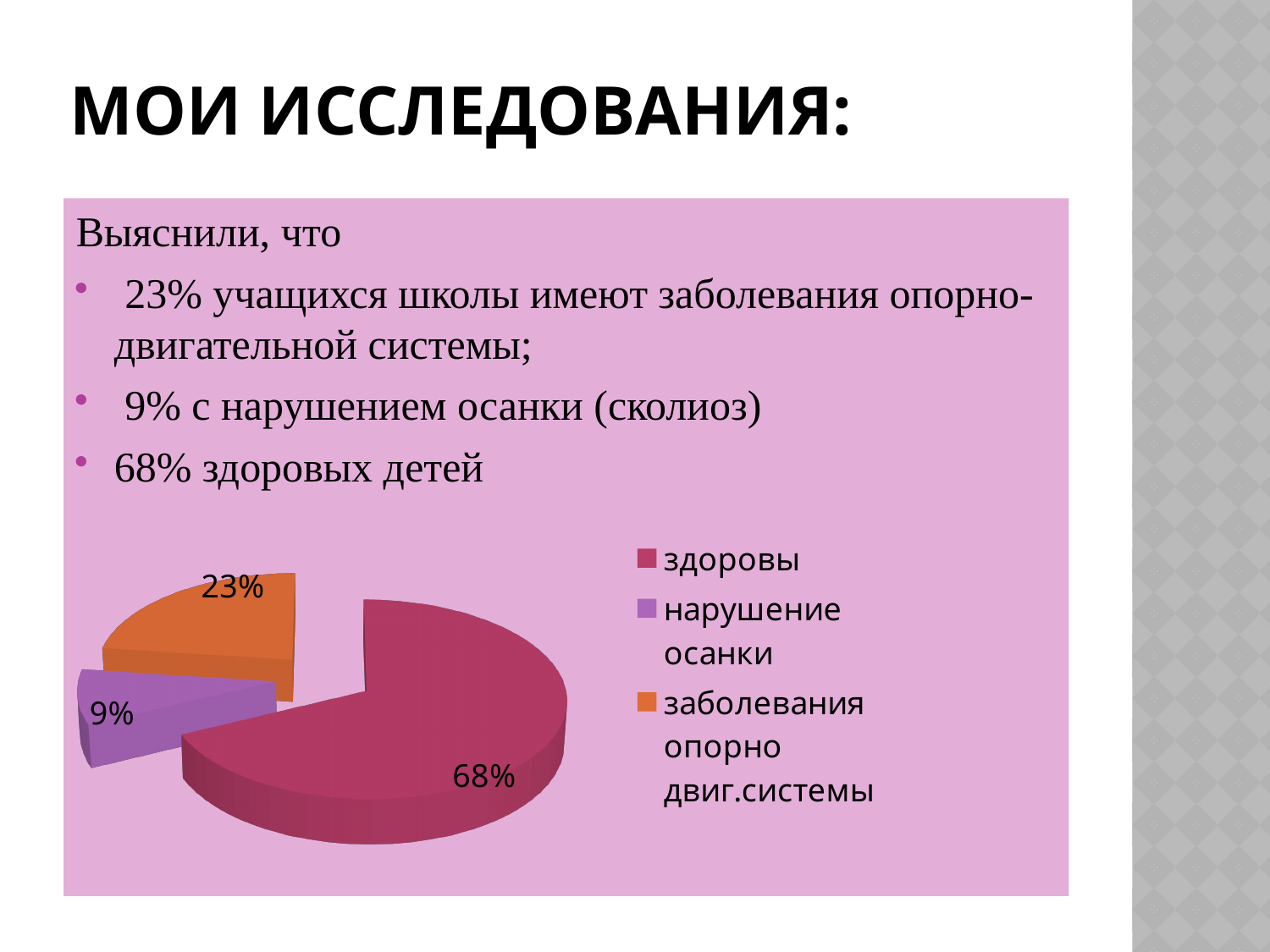
What share of the pie is labelled "здоровы"? 68% What colour is the slice for "заболевания опорно двиг.системы"? orange What share of the pie is labelled "заболевания опорно двиг.системы"? 23% How many entries does the legend list? 3 Which category has the smallest slice of the pie? нарушение осанки What is the difference in percentage points between the "здоровы" slice and the "заболевания опорно двиг.системы" slice? 45 What kind of chart is shown on the slide? pie chart Which category has the largest slice of the pie? здоровы How many slices does the pie chart have? 3 Which slice is larger: "нарушение осанки" or "заболевания опорно двиг.системы"? заболевания опорно двиг.системы What share of the pie is labelled "нарушение осанки"? 9% What colour is the slice for "здоровы"? dark pink (magenta)